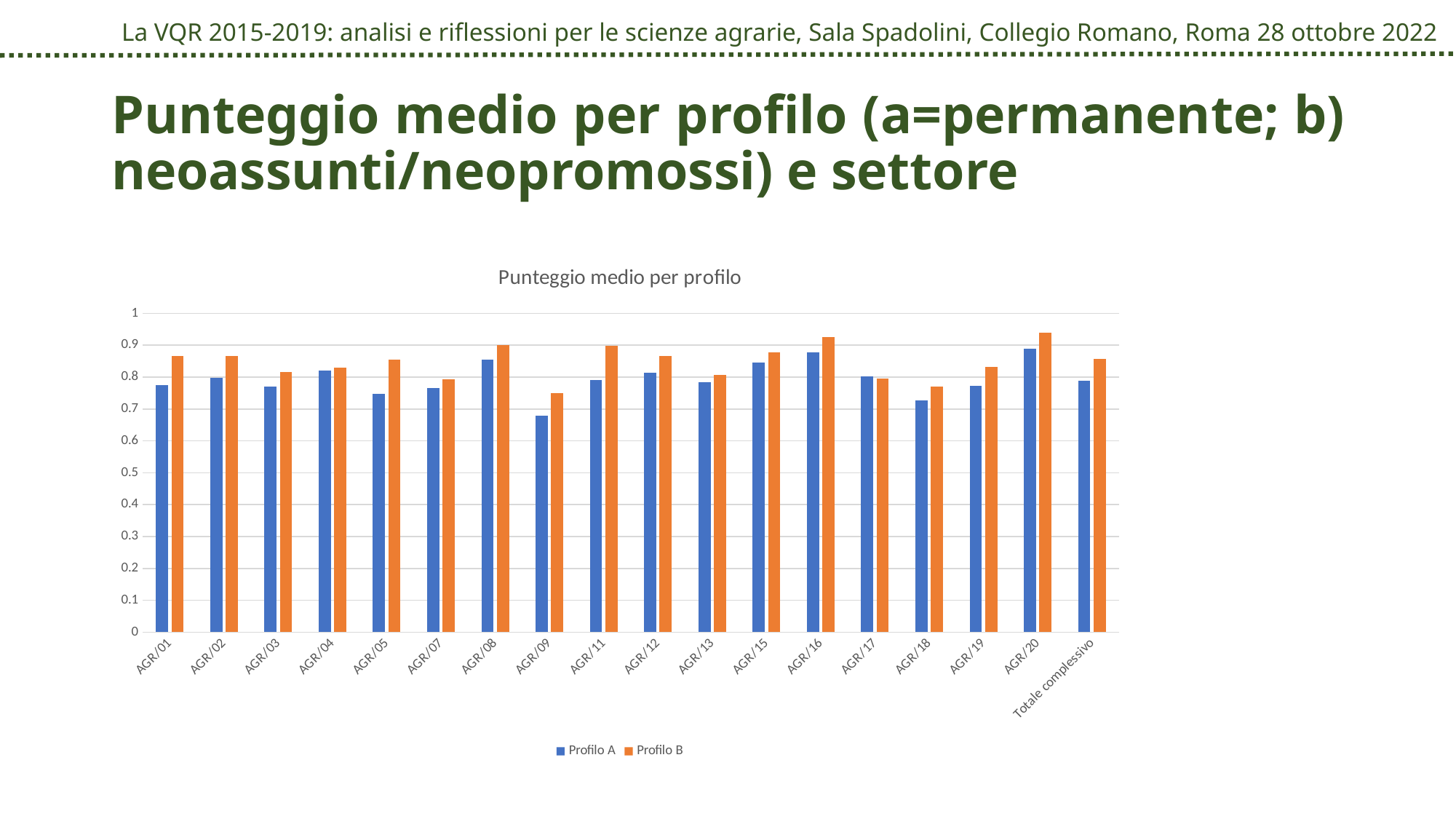
Is the Profilo B value for AGR/20 greater or less than 0.9? greater For AGR/09, which is larger: Profilo A or Profilo B? Profilo B Is the Profilo B value for AGR/16 greater or less than 0.9? greater For AGR/01, which is larger: Profilo A or Profilo B? Profilo B Which category has the lowest value for Profilo B? AGR/09 Is the Profilo A value for AGR/18 greater or less than 0.7? greater What is the title of the chart? Punteggio medio per profilo How many categories are shown on the x axis? 18 How many series does the legend list? 2 Which category has the lowest value for Profilo A? AGR/09 What kind of chart is shown on the slide? bar chart